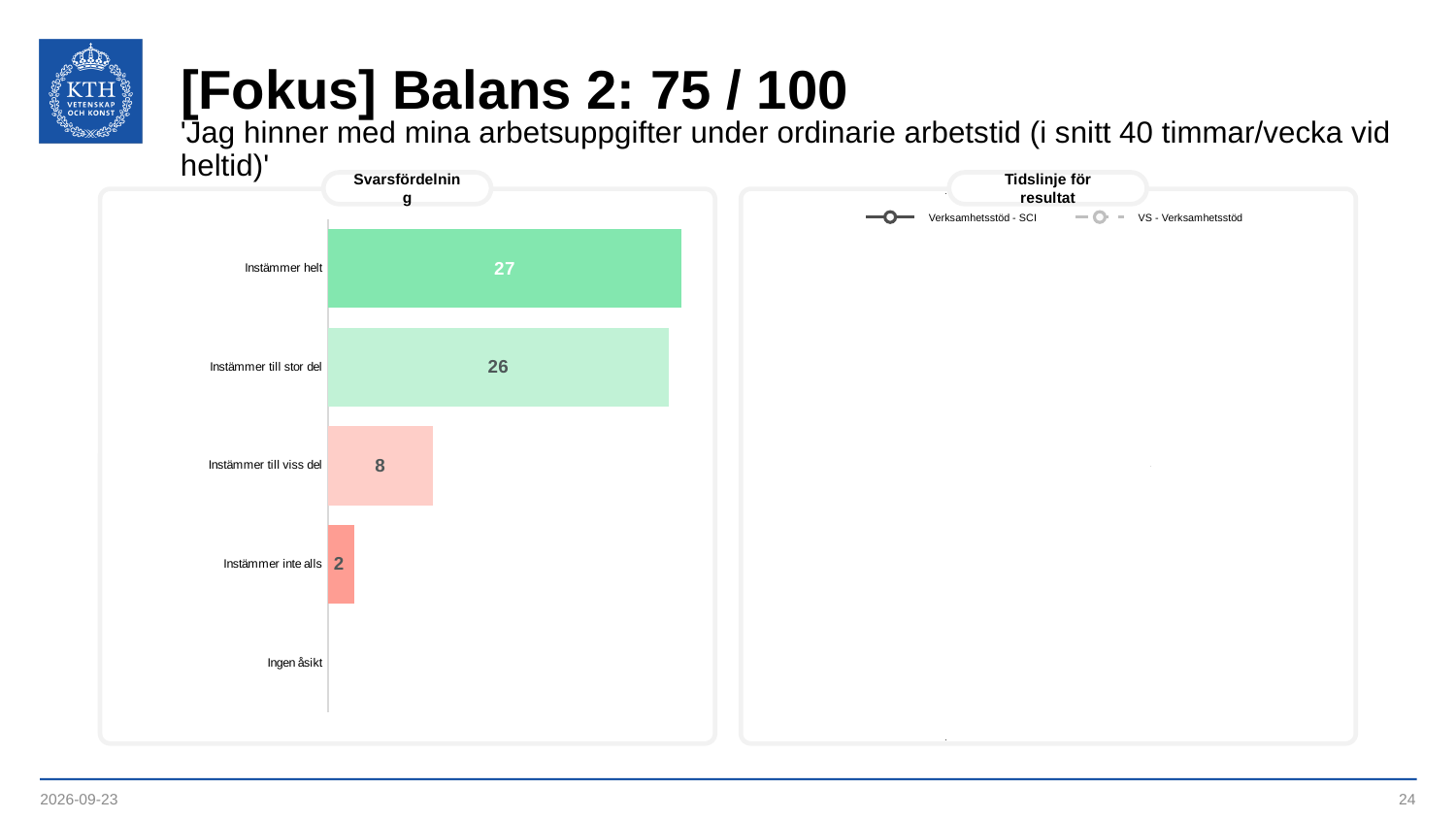
In the 'Svarsfördelning' chart, what is the value for 'Instämmer helt'? 27 What kind of chart is the 'Svarsfördelning' chart? Bar chart In the 'Svarsfördelning' chart, which is larger: 'Instämmer till viss del' or 'Instämmer inte alls'? Instämmer till viss del In the 'Svarsfördelning' chart, which category has the highest value? Instämmer helt How many categories are listed on the axis of the 'Svarsfördelning' chart? 5 In the 'Svarsfördelning' chart, what is the value for 'Instämmer inte alls'? 2 What are the legend entries of the 'Tidslinje för resultat' chart? Verksamhetsstöd - SCI and VS - Verksamhetsstöd In the 'Svarsfördelning' chart, what is the difference between 'Instämmer helt' and 'Instämmer inte alls'? 25 In the 'Svarsfördelning' chart, what is the value for 'Instämmer till viss del'? 8 How many series does the legend of the 'Tidslinje för resultat' chart list? 2 In the 'Svarsfördelning' chart, what is the value for 'Instämmer till stor del'? 26 In the 'Svarsfördelning' chart, what is the difference between 'Instämmer till stor del' and 'Instämmer till viss del'? 18